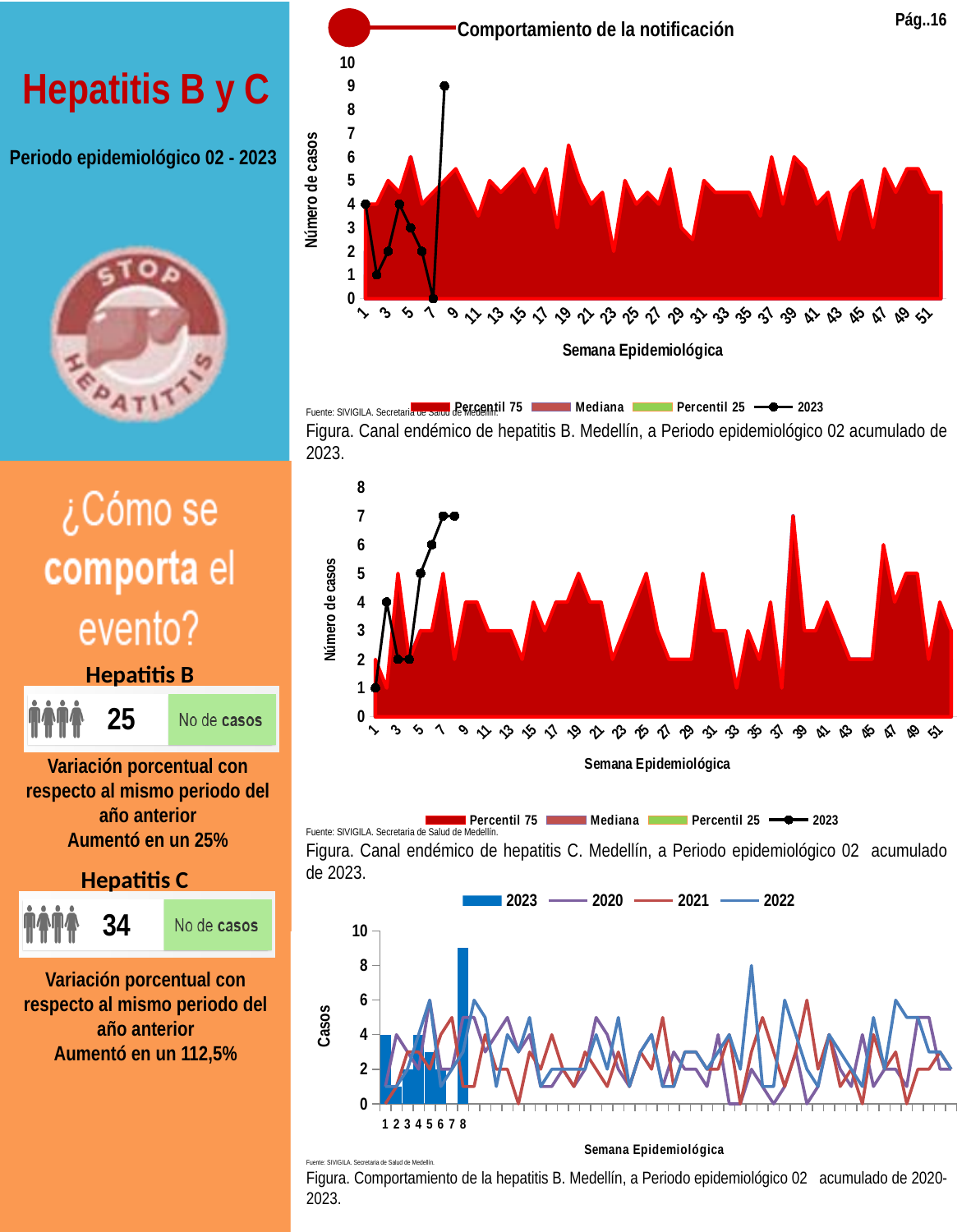
In the top chart (Canal endémico de hepatitis B), at which epidemiological week does the 2023 line reach its lowest value? Week 7 In the middle chart (Canal endémico de hepatitis C), which has the larger 2023 value, week 2 or week 3? Week 2 What is the label of the y axis in the top chart (Canal endémico de hepatitis B)? Número de casos In the top chart (Canal endémico de hepatitis B), what is the difference between the 2023 values at week 8 and week 7? 9 How many series does the legend of the bottom chart (Comportamiento de la hepatitis B 2020-2023) list? 4 In the middle chart (Canal endémico de hepatitis C), what is the value of the 2023 line at epidemiological week 7? 7 In the middle chart (Canal endémico de hepatitis C), what is the value of the 2023 line at epidemiological week 1? 1 How many series does the legend of the top chart (Canal endémico de hepatitis B) list? 4 In the bottom chart (Comportamiento de la hepatitis B 2020-2023), is the 2023 bar for week 8 greater or less than 8? greater In the middle chart (Canal endémico de hepatitis C), does the 2023 line rise or fall from week 5 to week 7? Rises In the top chart (Canal endémico de hepatitis B), at which epidemiological week does the 2023 line reach its highest value? Week 8 In the top chart (Canal endémico de hepatitis B), what is the value of the 2023 line at epidemiological week 8? 9